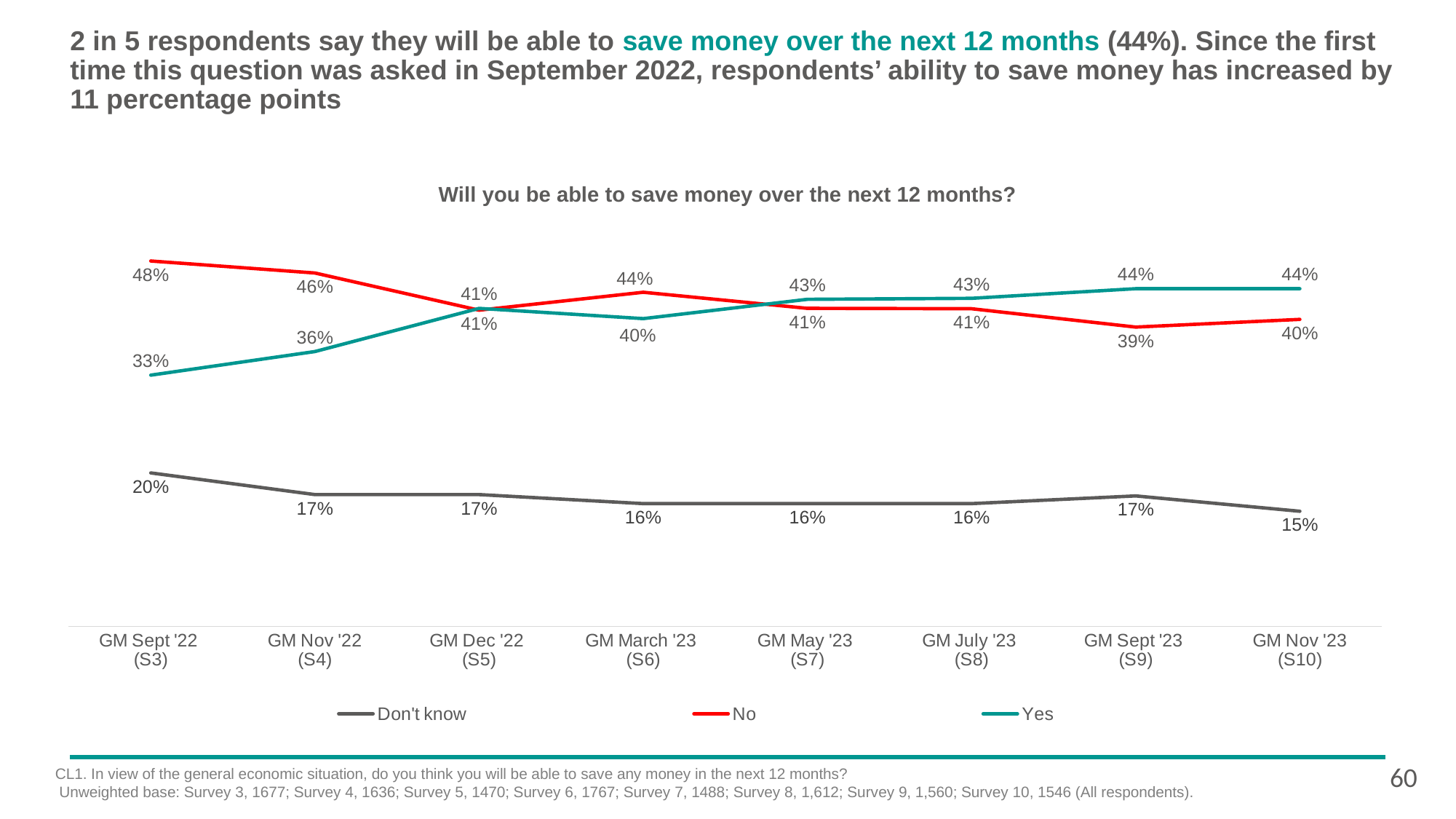
What type of chart is shown on the slide? line chart Which colour is used for the Yes series? teal At GM Sept '23 (S9), which is larger, Yes or No? Yes How many series does the legend list? 3 What is the value for No at GM Nov '23 (S10)? 40% What is the value for Yes at GM Sept '22 (S3)? 33% Does the Yes series generally rise or fall from GM Sept '22 to GM Nov '23? rise At which survey wave is the Don't know series lowest? GM Nov '23 (S10) How many survey waves are shown along the x axis? 8 At which survey wave is the No series highest? GM Sept '22 (S3) What is the value for Don't know at GM March '23 (S6)? 16% What is the difference between the Yes value at GM Nov '23 (S10) and at GM Sept '22 (S3)? 11 percentage points